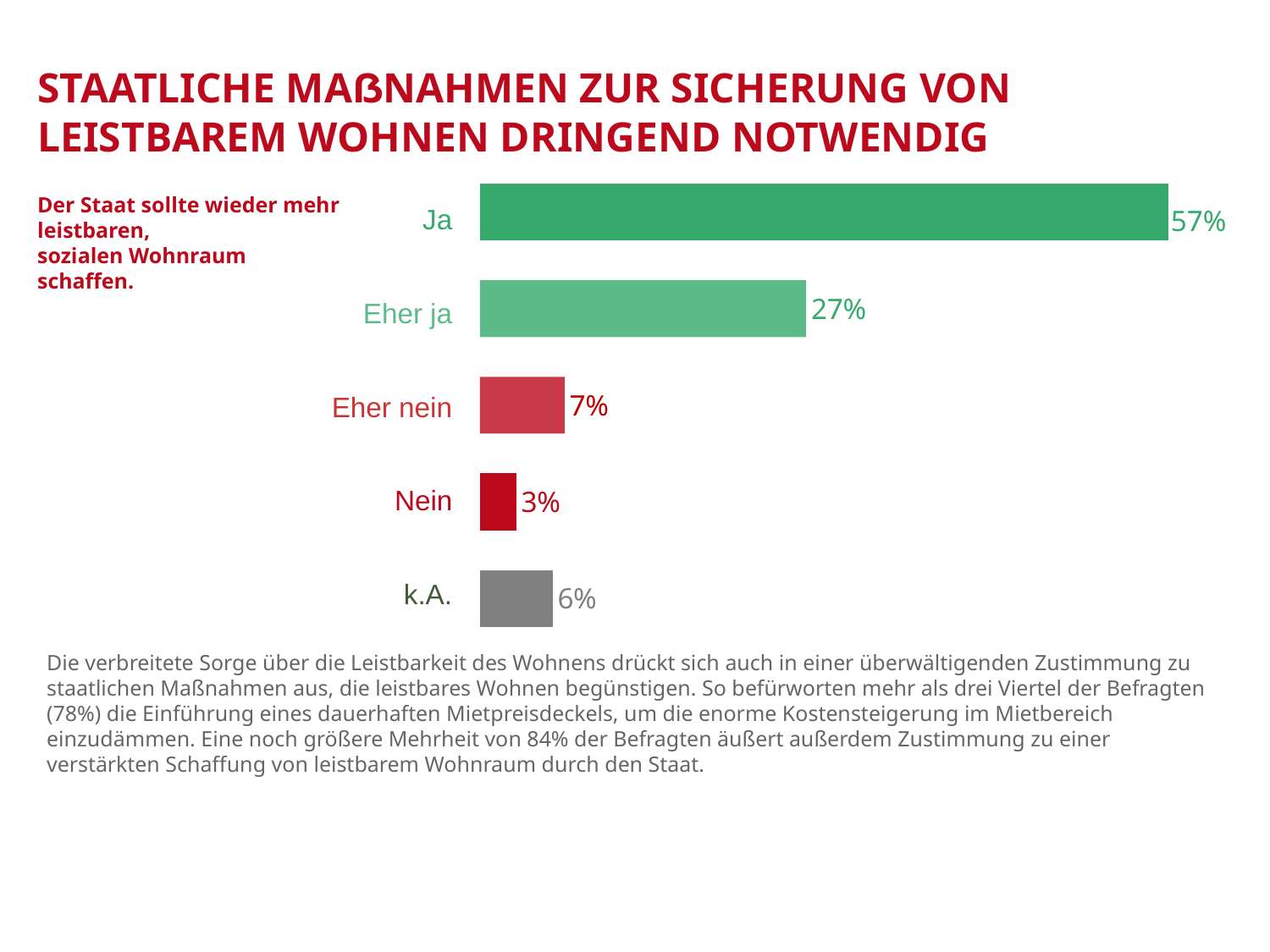
What percentage is shown for "k.A."? 6% What colour is the bar for "k.A."? Grey What kind of chart is shown on the slide? Bar chart What percentage of respondents answered "Ja"? 57% Which response category has the lowest value? Nein What is the value shown for "Eher ja"? 27% Which response category has the highest value? Ja How many response categories are shown in the chart? 5 What is the combined value of "Ja" and "Eher ja"? 84% What is the difference between the values for "Ja" and "Eher ja"? 30 percentage points What is the value shown for "Eher nein"? 7% Which is larger, the value for "Eher nein" or the value for "k.A."? Eher nein